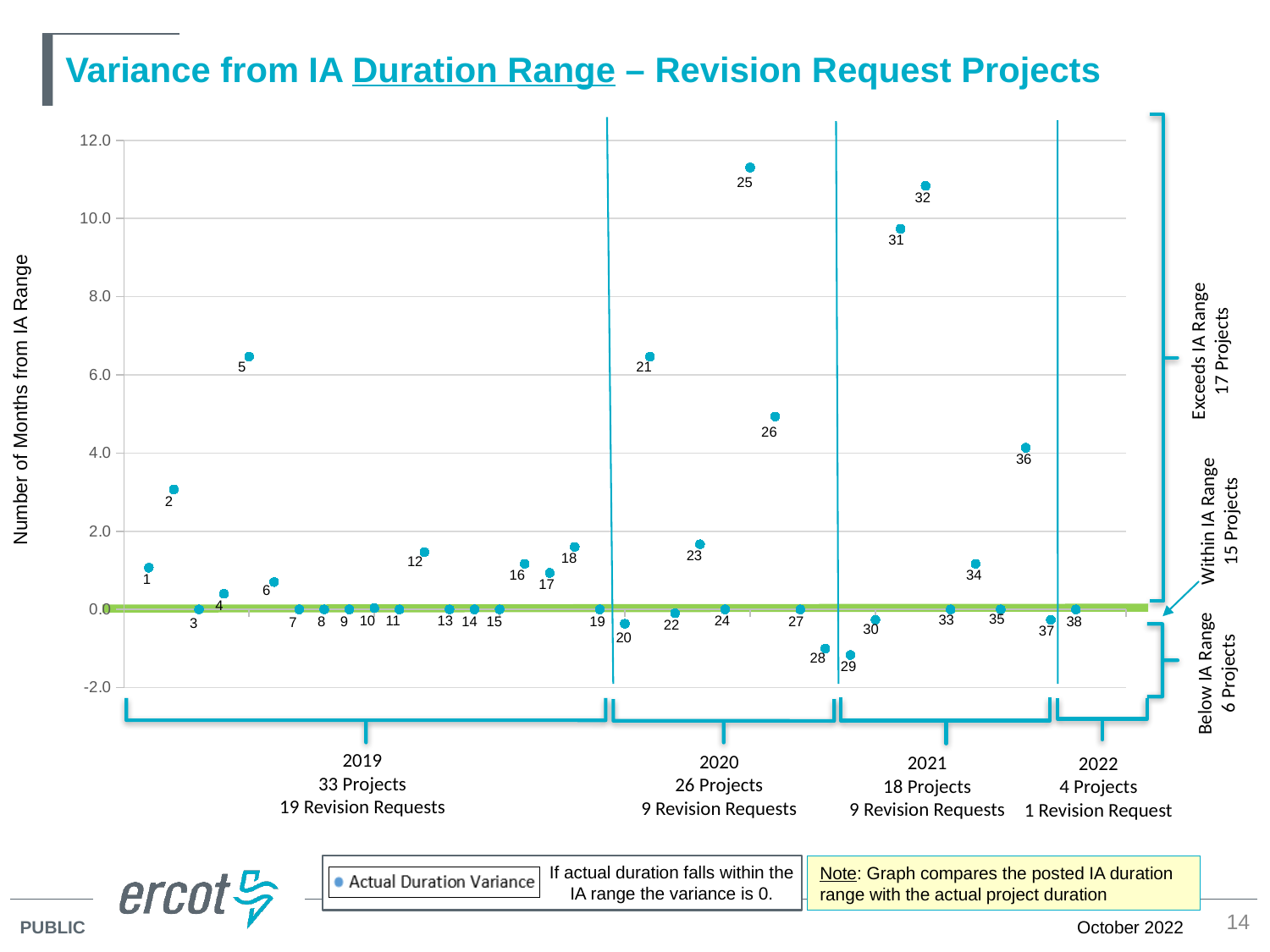
Is the value for project 26 greater or less than 6.0? less Is the value for project 31 greater or less than 10.0? less What is the variance value plotted for project 8? 0.0 Is the value for project 5 greater or less than 6.0? greater Which numbered project has the lowest variance from the IA range? 29 How many series does the legend list? 1 What type of chart is shown on the slide? scatter chart What is the title of the vertical axis? Number of Months from IA Range How many numbered project points are plotted on the chart? 38 Which numbered project has the highest variance from the IA range? 25 Which has the larger variance, project 25 or project 5? project 25